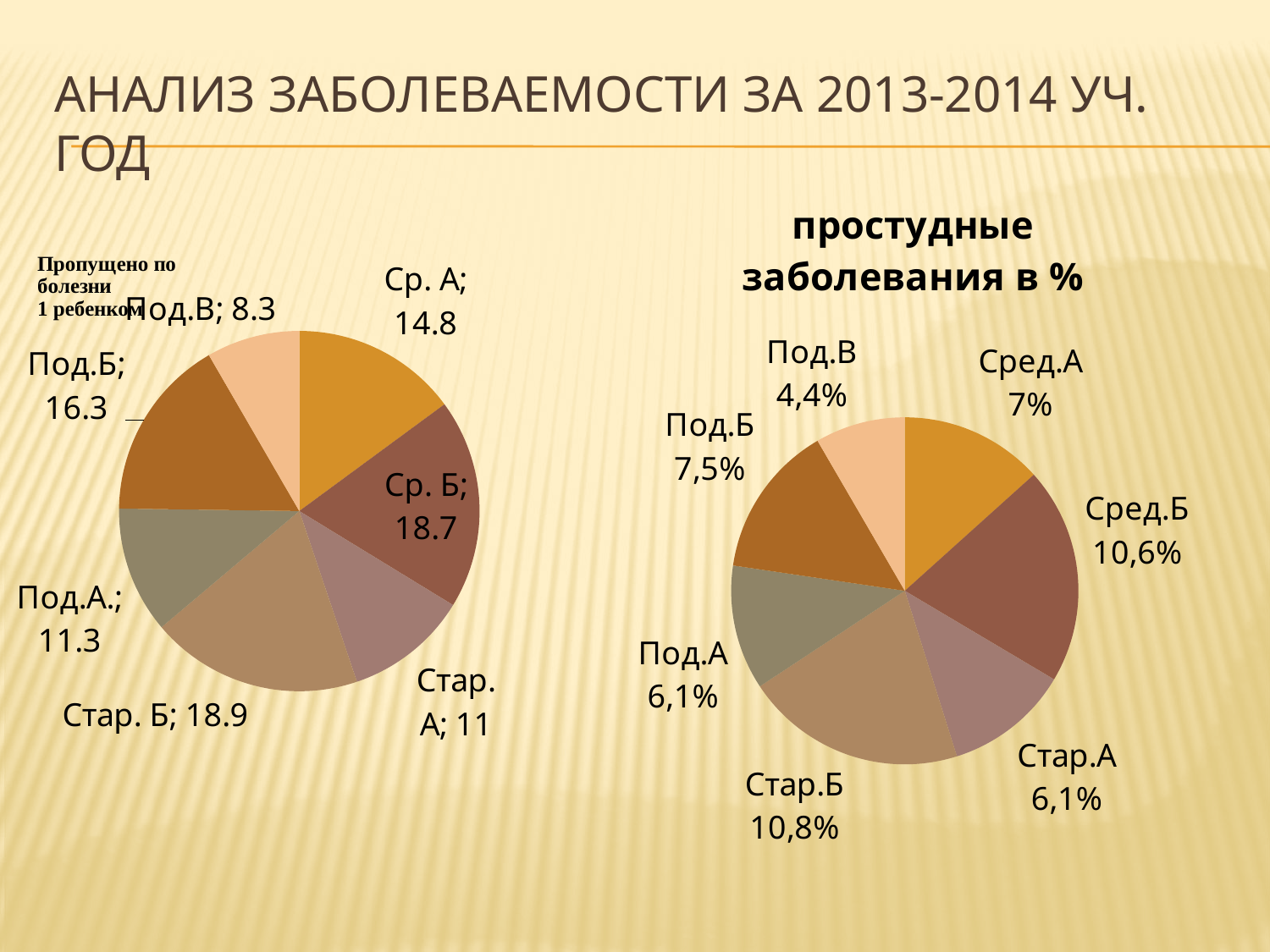
In the right pie chart (простудные заболевания в %), which is larger: Под.Б or Сред.А? Под.Б What is the title of the chart on the right side of the slide? простудные заболевания в % In the left pie chart (Пропущено по болезни 1 ребенком), which category has the lowest value? Под.В In the left pie chart (Пропущено по болезни 1 ребенком), what is the value for Под.Б? 16.3 In the left pie chart (Пропущено по болезни 1 ребенком), what is the difference between Ср. А and Стар. А? 3.8 In the right pie chart (простудные заболевания в %), what is the value for Сред.Б? 10,6% What type of chart is used on the right side of the slide (простудные заболевания в %)? Pie chart In the left pie chart (Пропущено по болезни 1 ребенком), how many categories are shown? 7 In the left pie chart (Пропущено по болезни 1 ребенком), which is larger: Под.А. or Под.В? Под.А. In the right pie chart (простудные заболевания в %), what is the value for Под.В? 4,4% In the right pie chart (простудные заболевания в %), which category has the smallest share? Под.В In the left pie chart (Пропущено по болезни 1 ребенком), what is the value for Ср. Б? 18.7